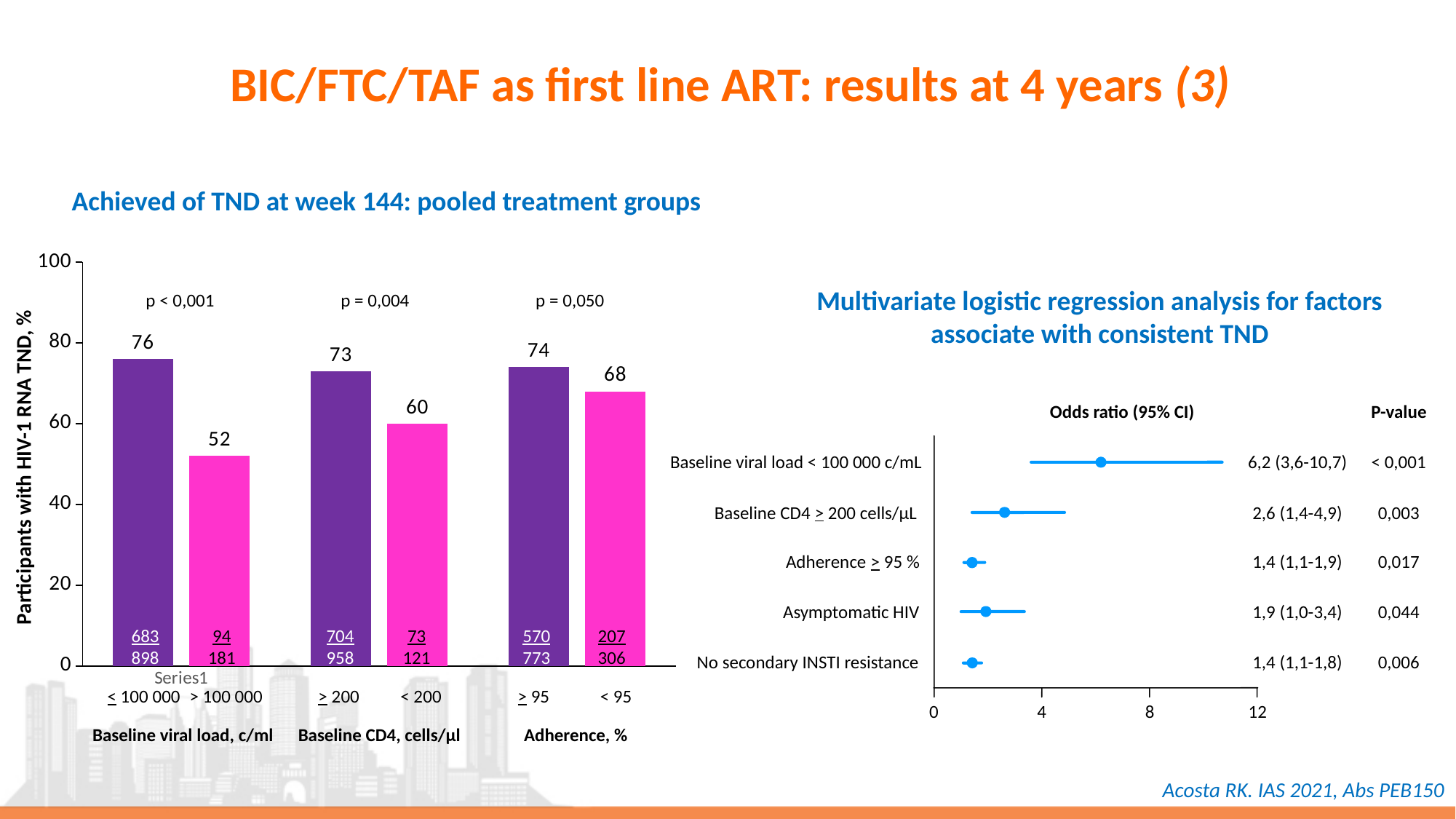
In the forest plot 'Multivariate logistic regression analysis', what is the odds ratio (95% CI) for baseline viral load < 100 000 c/mL? 6,2 (3,6-10,7) In the bar chart 'Achieved of TND at week 144', what is the difference between the values for baseline CD4 ≥ 200 and < 200 cells/µl? 13 In the bar chart 'Achieved of TND at week 144', how many bars are plotted? 6 In the bar chart 'Achieved of TND at week 144', which category has the highest percentage of participants with HIV-1 RNA TND? ≤ 100 000 (baseline viral load) In the bar chart 'Achieved of TND at week 144', what is the value for adherence < 95%? 68 In the bar chart 'Achieved of TND at week 144', what is the value for participants with baseline viral load > 100 000 c/ml? 52 In the bar chart 'Achieved of TND at week 144', what p-value is shown for the baseline viral load comparison? p < 0,001 In the bar chart 'Achieved of TND at week 144', which category has the lowest percentage of participants with HIV-1 RNA TND? > 100 000 (baseline viral load) In the forest plot 'Multivariate logistic regression analysis', what is the P-value for Asymptomatic HIV? 0,044 In the bar chart 'Achieved of TND at week 144', which is larger: the value for adherence ≥ 95% or adherence < 95%? Adherence ≥ 95% In the forest plot 'Multivariate logistic regression analysis', which factor has the highest odds ratio? Baseline viral load < 100 000 c/mL In the bar chart 'Achieved of TND at week 144', what percentage of participants with baseline viral load ≤ 100 000 c/ml achieved TND? 76